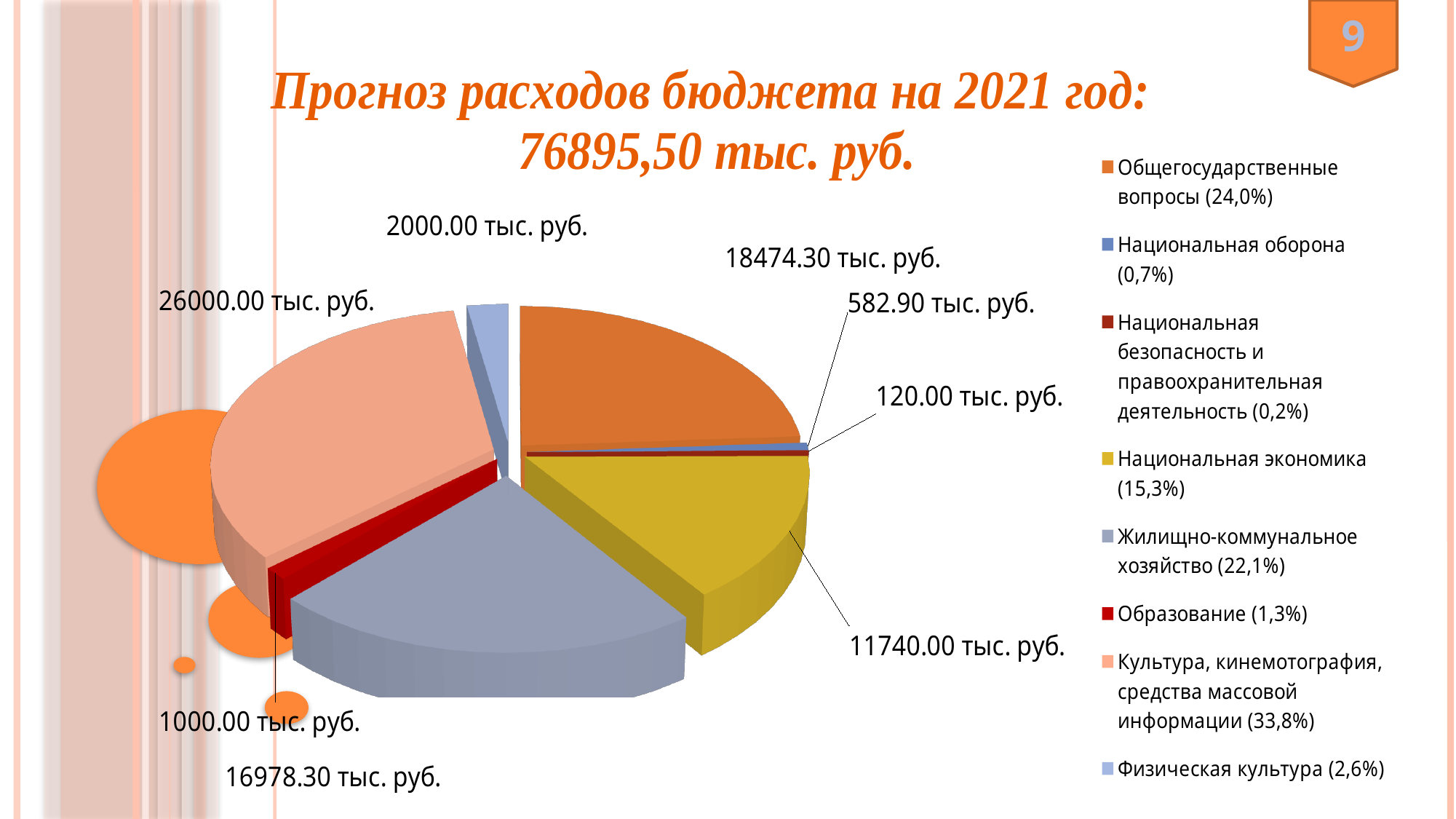
What is the value shown for Национальная экономика? 11740.00 тыс. руб. What total budget expenditure for 2021 is stated in the chart title? 76895,50 тыс. руб. Which is larger: the value for Образование or the value for Физическая культура? Физическая культура What is the value shown for Культура, кинемотография, средства массовой информации? 26000.00 тыс. руб. How many categories does the legend of the pie chart list? 8 What is the value shown for Общегосударственные вопросы? 18474.30 тыс. руб. What is the value shown for Национальная оборона? 582.90 тыс. руб. Which category has the largest slice of the pie? Культура, кинемотография, средства массовой информации What kind of chart is shown on the slide? Pie chart What share of the pie does Жилищно-коммунальное хозяйство represent, according to the legend? 22,1% What is the difference between the values for Культура, кинемотография, средства массовой информации and Общегосударственные вопросы? 7525.70 тыс. руб. Which category has the smallest slice of the pie? Национальная безопасность и правоохранительная деятельность